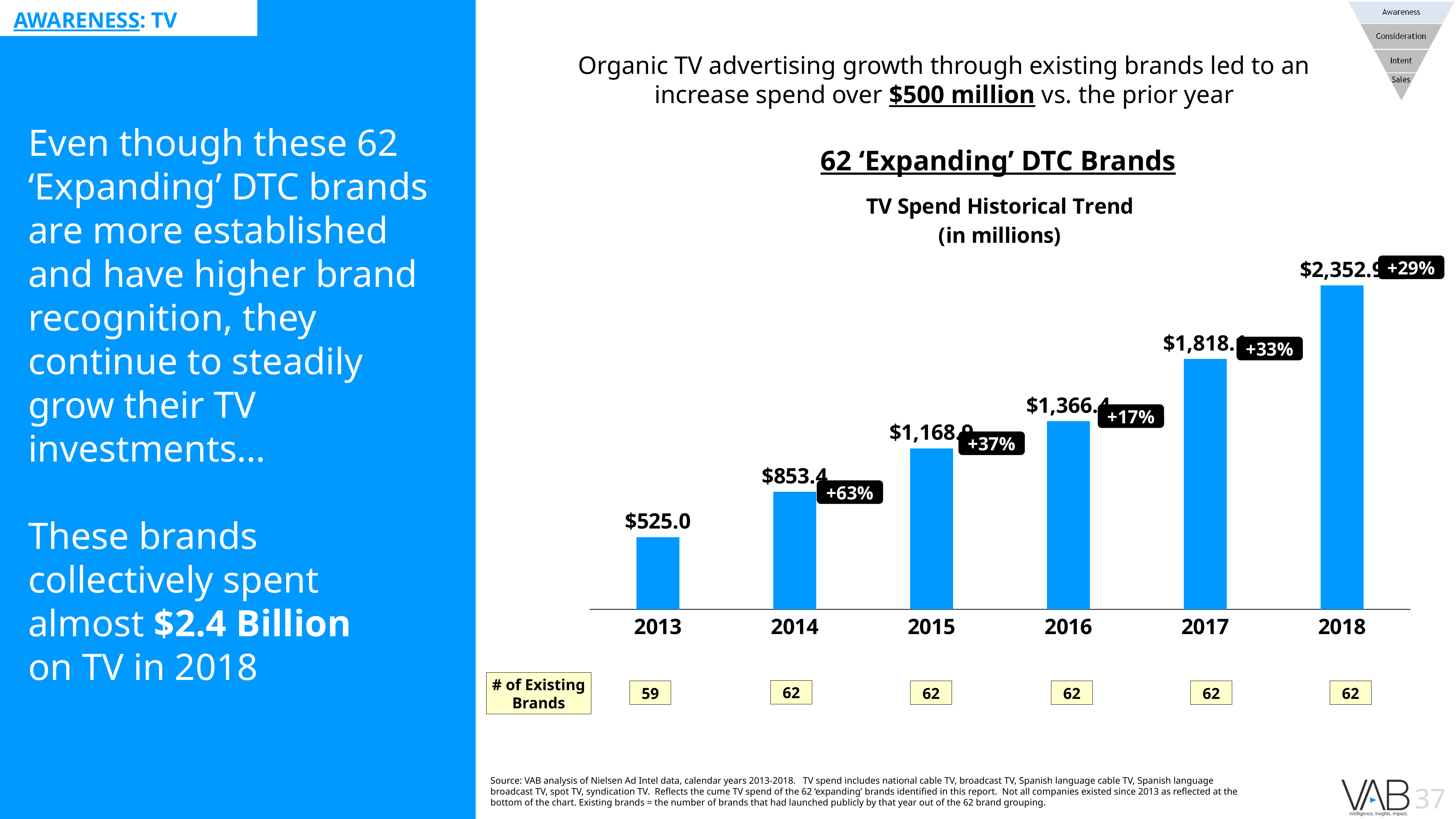
What year-over-year growth percentage is shown for 2016? +17% What was the TV spend (in millions) for the 62 'Expanding' DTC brands in 2014? $853.4 Which year had the larger TV spend, 2016 or 2015? 2016 How many years are shown on the x axis of the TV Spend Historical Trend chart? 6 What year-over-year growth percentage is shown for 2014? +63% What was the TV spend (in millions) for the 62 'Expanding' DTC brands in 2013? $525.0 What is the difference in TV spend (in millions) between 2014 and 2013? $328.4 Which year has the lowest TV spend in the chart? 2013 Do the TV spend values rise or fall from 2013 to 2018? rise Which year has the highest TV spend in the chart? 2018 What kind of chart is shown on the slide? bar chart How many existing brands are shown for 2013 below the chart? 59